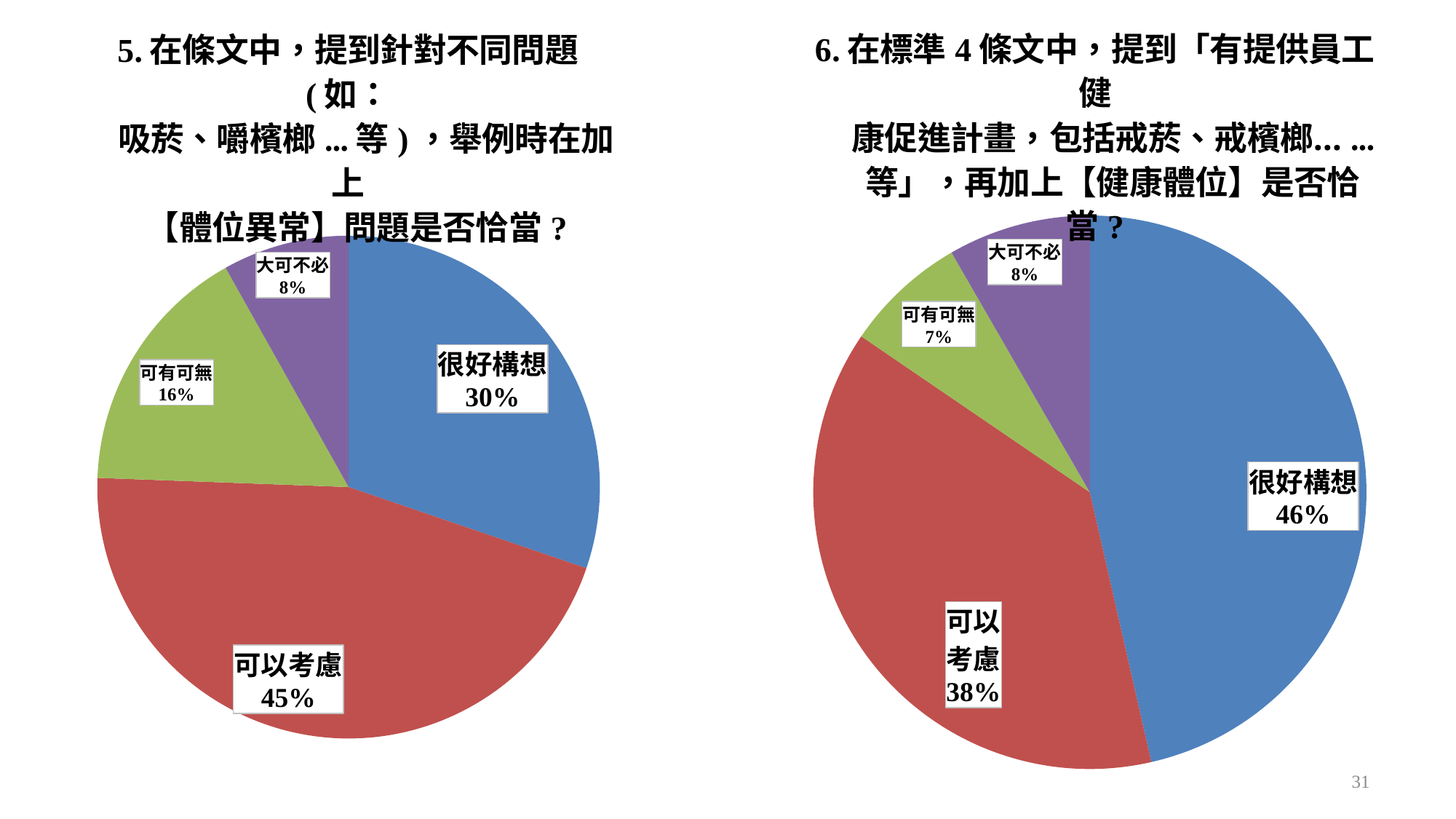
In the right pie chart (question 6), which is larger, 大可不必 or 可有可無? 大可不必 In the right pie chart (question 6), what share is labelled for 可有可無? 7% In the right pie chart (question 6), which category has the largest slice? 很好構想 In the left pie chart (question 5), which category has the smallest slice? 大可不必 In the left pie chart (question 5), what share is labelled for 可以考慮? 45% In the left pie chart (question 5), which category has the largest slice? 可以考慮 What type of chart is used on the left side of the slide (question 5)? Pie chart In the right pie chart (question 6), what share is labelled for 很好構想? 46% In the left pie chart (question 5), what share is labelled for 很好構想? 30% In the right pie chart (question 6), what is the difference between the shares for 很好構想 and 可以考慮? 8% In the left pie chart (question 5), what is the difference between the shares for 可以考慮 and 很好構想? 15% In the left pie chart (question 5), how many slices are there? 4